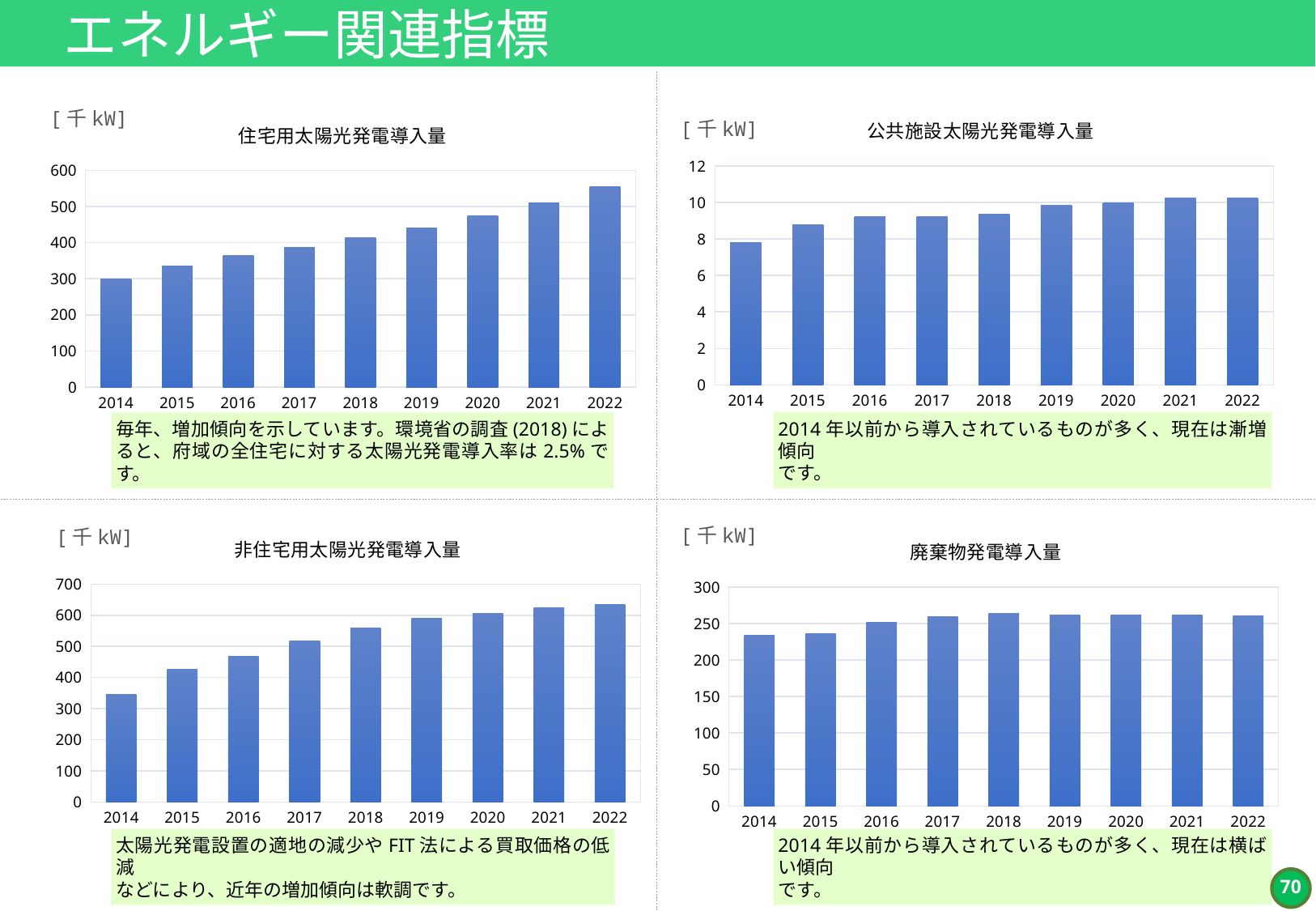
In the 公共施設太陽光発電導入量 chart (top right), is the value for 2021 greater or less than 10? greater In the 住宅用太陽光発電導入量 chart (top left), how many years are plotted? 9 In the 廃棄物発電導入量 chart (bottom right), is the value for 2014 greater or less than 250? less In the 公共施設太陽光発電導入量 chart (top right), which year has the lowest value? 2014 In the 非住宅用太陽光発電導入量 chart (bottom left), is the value for 2014 greater or less than 400? less In the 非住宅用太陽光発電導入量 chart (bottom left), do the values rise or fall from 2014 to 2022? rise What kind of chart is the 廃棄物発電導入量 chart (bottom right)? bar chart In the 公共施設太陽光発電導入量 chart (top right), which is larger, the value for 2014 or the value for 2019? 2019 In the 非住宅用太陽光発電導入量 chart (bottom left), which year has the highest value? 2022 In the 住宅用太陽光発電導入量 chart (top left), which year has the highest value? 2022 In the 住宅用太陽光発電導入量 chart (top left), which year has the lowest value? 2014